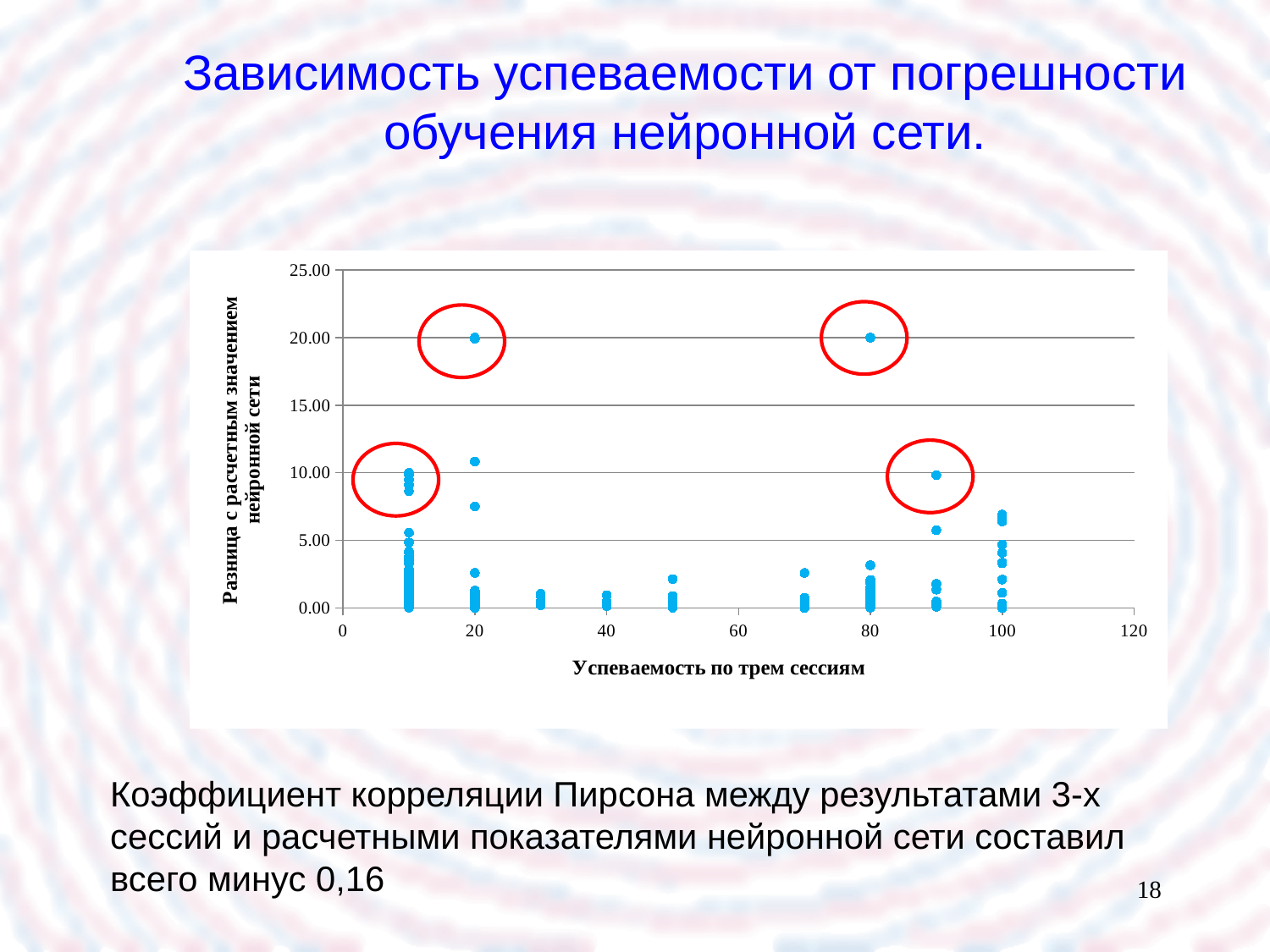
Is the highest point at x = 70 greater or less than 5.00? less What is the y value of the circled point at x = 20? 20.00 How many tick labels are shown on the horizontal axis? 7 Is the highest point at x = 90 greater or less than 5.00? greater Is the highest point at x = 100 greater or less than 10.00? less How many red circles are drawn on the chart to highlight points? 4 What kind of chart is shown on the slide? scatter plot What is the title of the horizontal axis of the chart? Успеваемость по трем сессиям What is the y value of the circled point at x = 80? 20.00 What is the largest value labelled on the vertical axis? 25.00 Which has the higher topmost point: x = 20 or x = 90? x = 20